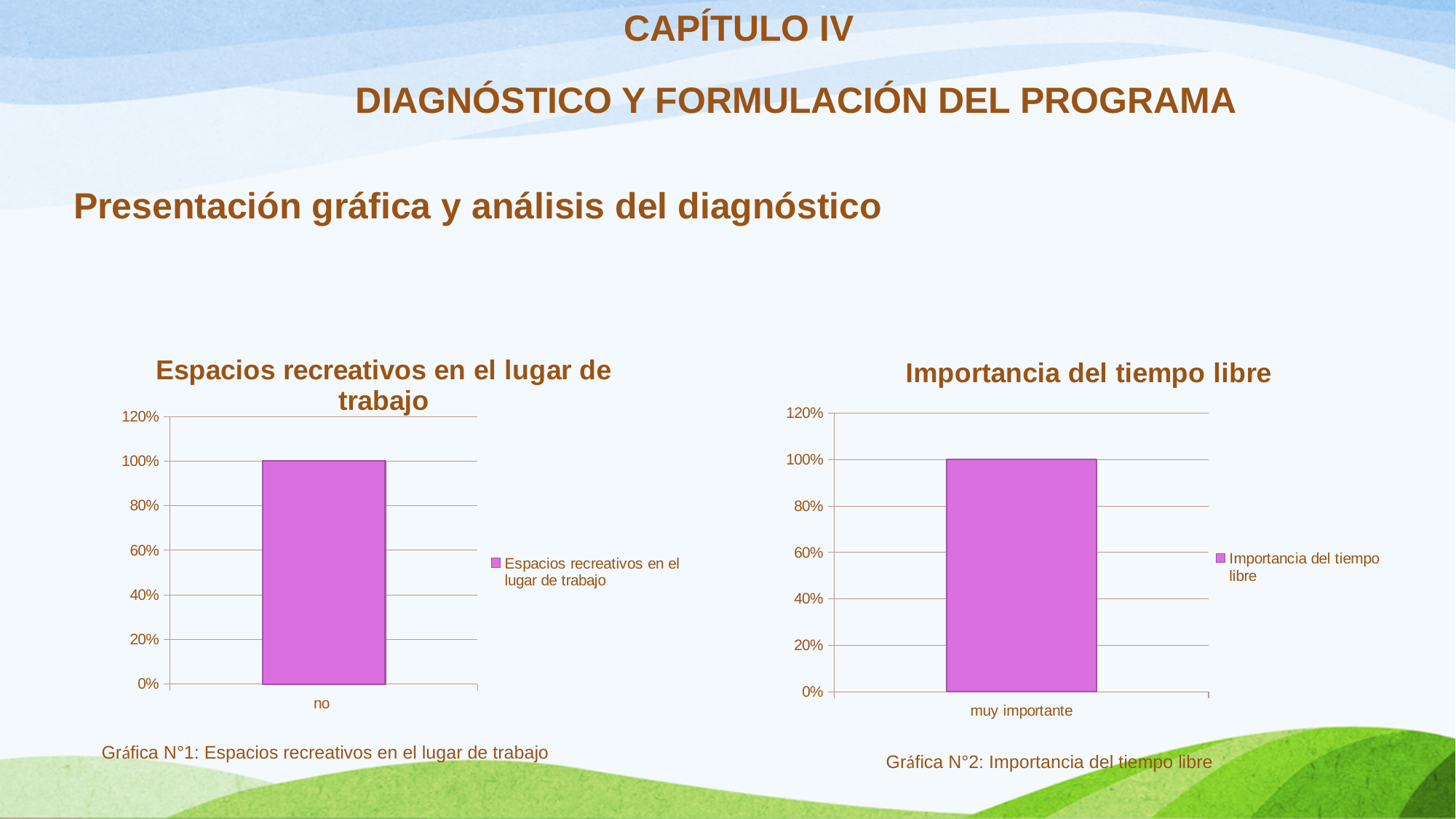
In the chart titled "Importancia del tiempo libre", what is the value for the category "muy importante"? 100% What kind of chart is the left chart, "Espacios recreativos en el lugar de trabajo"? bar chart What kind of chart is the right chart, "Importancia del tiempo libre"? bar chart How many series does the legend of the chart titled "Importancia del tiempo libre" list? 1 How many categories are shown on the x axis of the chart titled "Espacios recreativos en el lugar de trabajo"? 1 How many series does the legend of the chart titled "Espacios recreativos en el lugar de trabajo" list? 1 How many categories are shown on the x axis of the chart titled "Importancia del tiempo libre"? 1 In the chart titled "Espacios recreativos en el lugar de trabajo", is the value for "no" greater or less than 80%? greater In the chart titled "Espacios recreativos en el lugar de trabajo", what is the value for the category "no"? 100% In the chart titled "Importancia del tiempo libre", is the value for "muy importante" greater or less than 120%? less What is the legend entry of the left chart, "Espacios recreativos en el lugar de trabajo"? Espacios recreativos en el lugar de trabajo What is the category label on the x axis of the chart titled "Importancia del tiempo libre"? muy importante